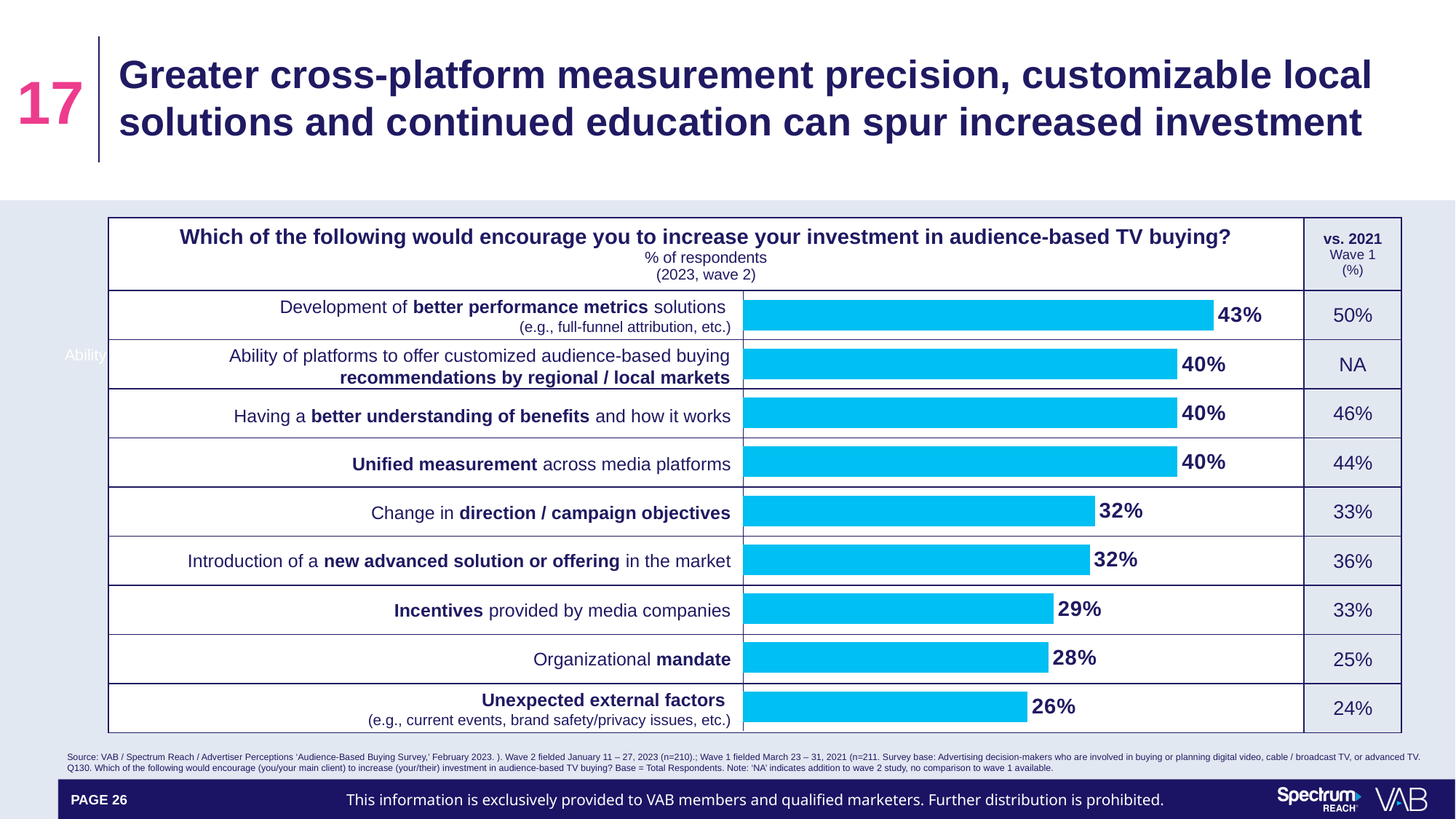
What is the difference in percentage points between the highest bar (43%) and the lowest bar (26%)? 17 percentage points According to the 'vs. 2021 Wave 1' column, what was the 2021 value for development of better performance metrics solutions? 50% What is the 2023 (wave 2) value for incentives provided by media companies? 29% Which factor has the lowest percentage of respondents in 2023 (wave 2)? Unexpected external factors What kind of chart is shown on the slide? bar chart Which factor has the highest percentage of respondents in 2023 (wave 2)? Development of better performance metrics solutions What is the 2023 (wave 2) value for unified measurement across media platforms? 40% Which has a higher 2023 (wave 2) value: development of better performance metrics solutions or change in direction / campaign objectives? Development of better performance metrics solutions Do the bar values increase or decrease going from the top of the chart to the bottom? decrease What percentage of respondents in 2023 (wave 2) said development of better performance metrics solutions would encourage them to increase investment? 43% How many factors (bars) are shown in the chart? 9 What is the 2023 (wave 2) value for organizational mandate? 28%